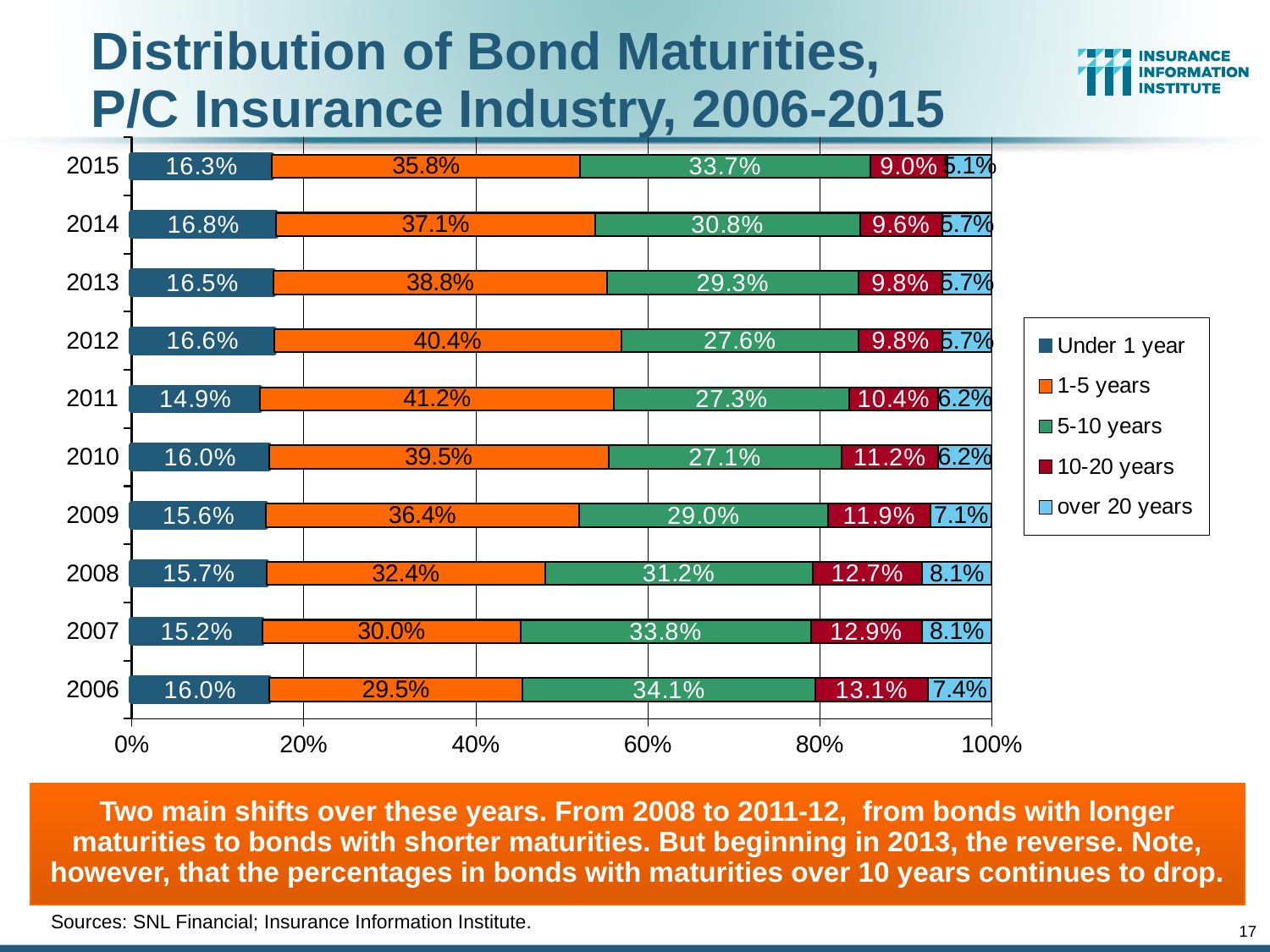
What is the value for Under 1 year in 2015? 16.3% How many maturity categories does the legend list? 5 Does the 10-20 years share rise or fall from 2006 to 2015? Fall In which year was the 10-20 years share the lowest? 2015 What kind of chart is shown on the slide? Stacked bar chart What is the difference between the 1-5 years share in 2011 and in 2006? 11.7 percentage points In 2015, which is larger: the 1-5 years share or the 5-10 years share? 1-5 years What percentage of bonds had maturities of 1-5 years in 2011? 41.2% What share of bonds had 10-20 year maturities in 2010? 11.2% How many years are shown on the chart? 10 What is the value for 5-10 years in 2009? 29.0% In which year was the 1-5 years share the highest? 2011